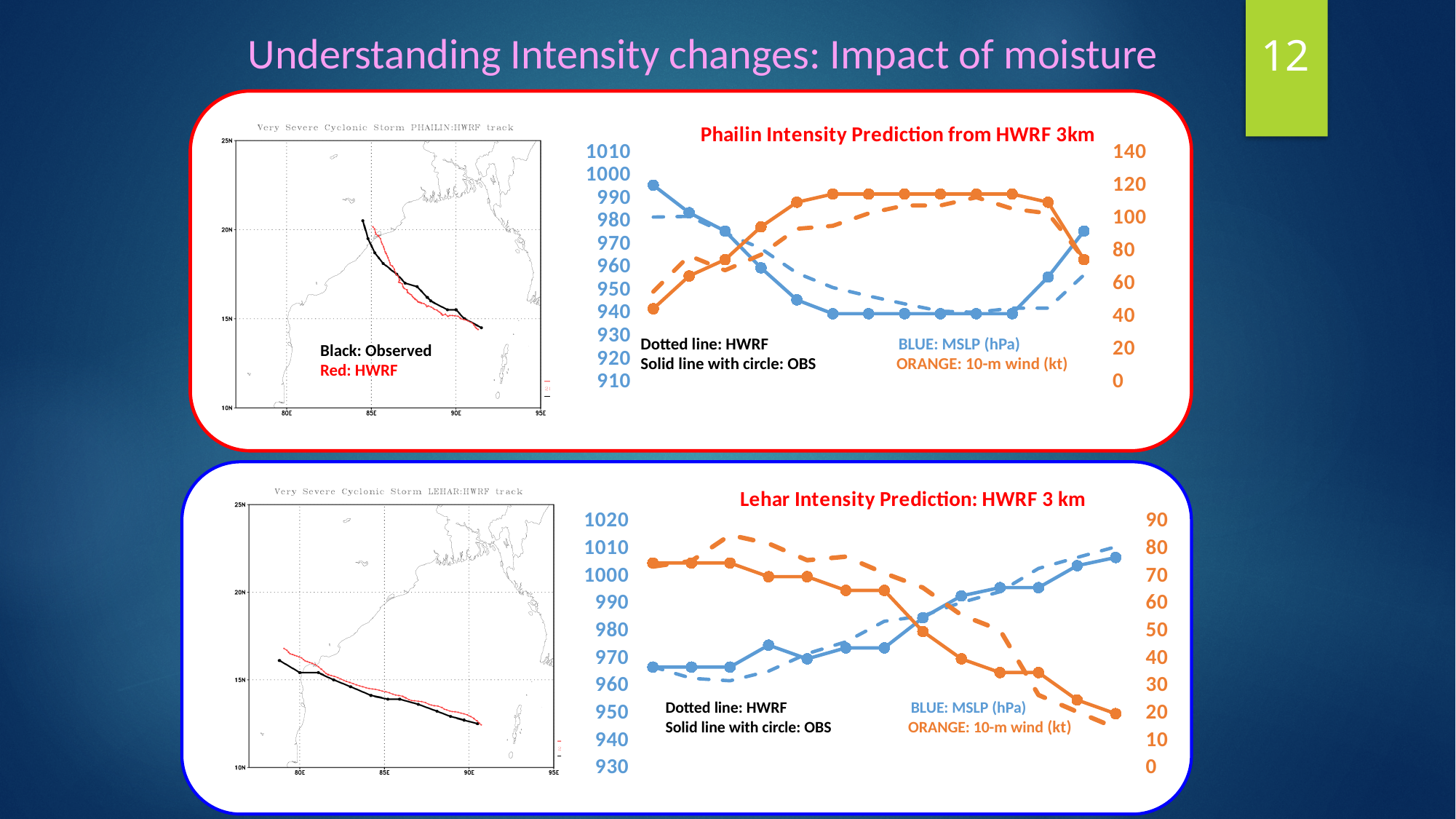
In the 'Lehar Intensity Prediction: HWRF 3 km' chart, what does the dotted line represent? HWRF In the 'Lehar Intensity Prediction: HWRF 3 km' chart, does the observed MSLP (solid blue line) rise or fall overall from left to right? rise What kind of chart is the 'Phailin Intensity Prediction from HWRF 3km' chart? line chart In the 'Phailin Intensity Prediction from HWRF 3km' chart, what does the blue line represent? MSLP (hPa) How many circled points does the solid blue observed MSLP line have in the 'Phailin Intensity Prediction from HWRF 3km' chart? 13 In the 'Lehar Intensity Prediction: HWRF 3 km' chart, is the observed MSLP (solid blue line) at the last point greater or less than 1000? greater Which chart shows a higher peak observed 10-m wind: 'Phailin Intensity Prediction from HWRF 3km' or 'Lehar Intensity Prediction: HWRF 3 km'? Phailin Intensity Prediction from HWRF 3km In the 'Lehar Intensity Prediction: HWRF 3 km' chart, is the observed 10-m wind (solid orange line) at the last point greater or less than 30? less In the 'Lehar Intensity Prediction: HWRF 3 km' chart, does the observed 10-m wind (solid orange line) rise or fall from left to right? fall In the 'Phailin Intensity Prediction from HWRF 3km' chart, is the lowest observed MSLP (solid blue line) greater or less than 950? less In the 'Phailin Intensity Prediction from HWRF 3km' chart, is the observed 10-m wind (solid orange line) larger at the first point or at the last point? last point